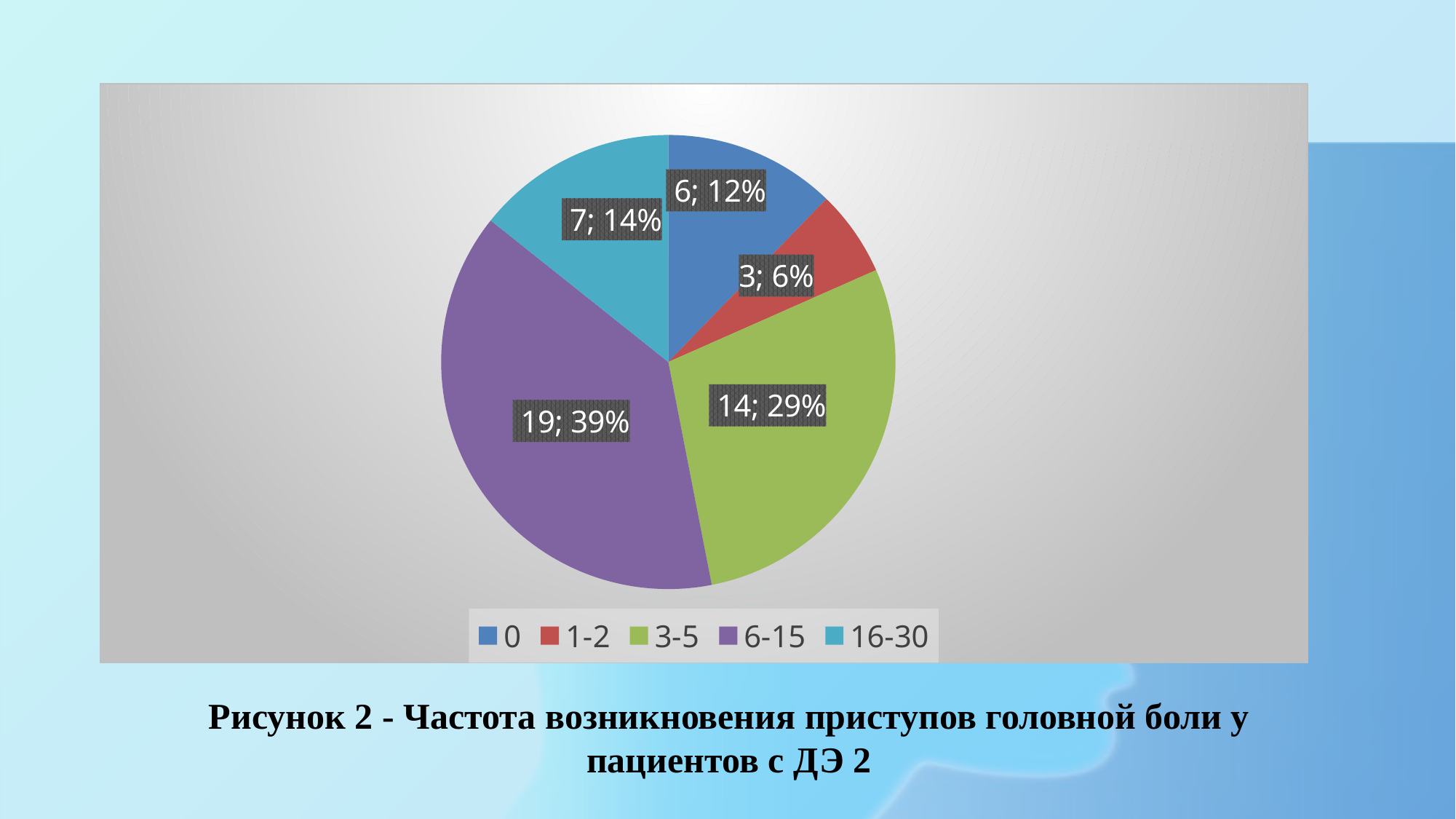
Which category has the largest slice? 6-15 What colour is the "6-15" slice? purple Which is larger, the "16-30" slice or the "0" slice? 16-30 What is the difference between the counts for "6-15" and "3-5"? 5 What percentage is shown for the "3-5" slice? 29% What is the count shown for the "6-15" slice? 19 What kind of chart is shown on the slide? pie chart How many slices does the pie chart have? 5 What is the count shown for the "1-2" slice? 3 What percentage is shown for the "0" slice? 12% Which category has the smallest slice? 1-2 How many entries does the legend list? 5